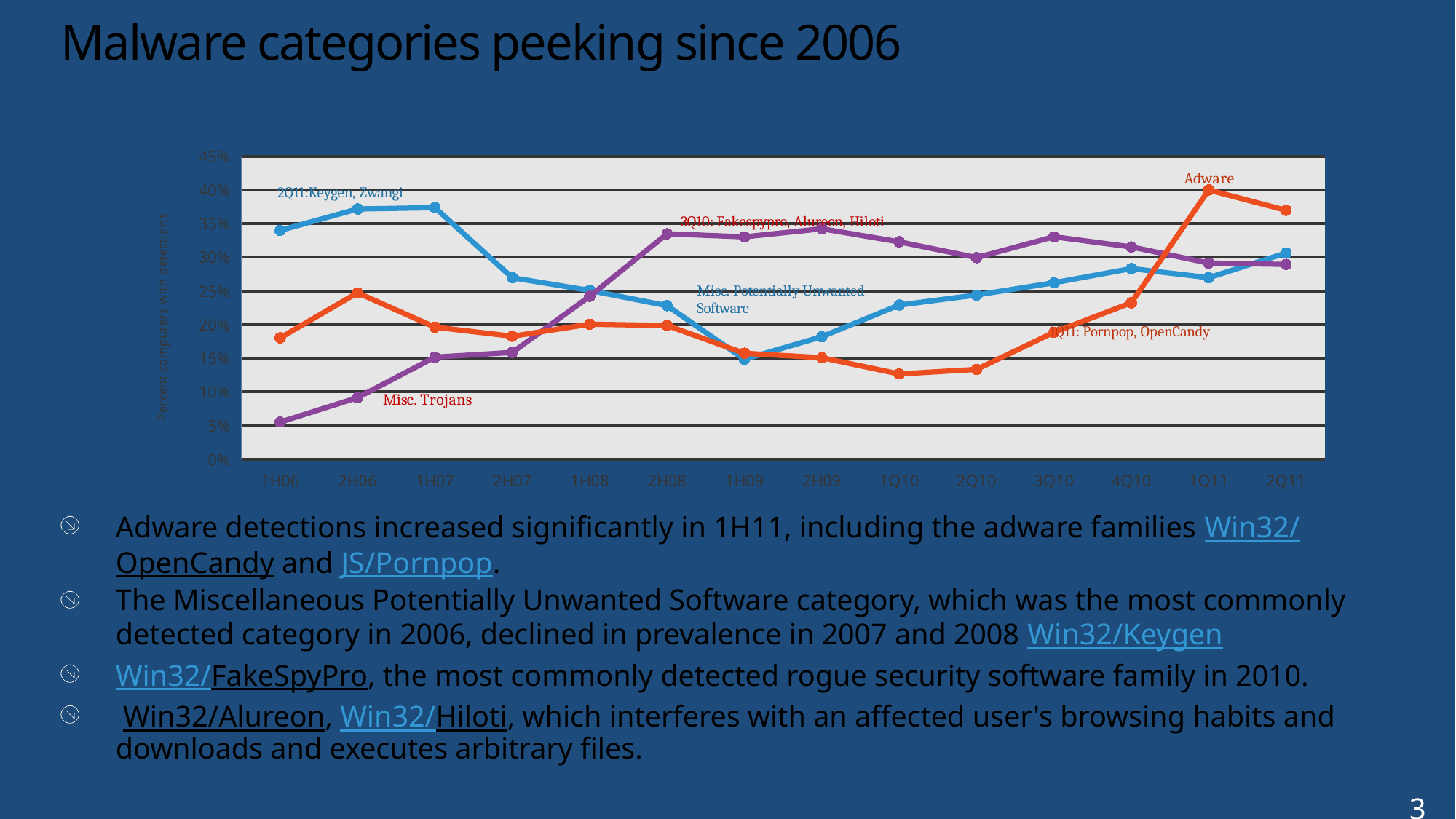
What is the label on the y axis of the chart? Percent computers with detections In 2H08, which series has the larger value: Misc. Trojans or Adware? Misc. Trojans How many data series are plotted on the chart? 3 Does the Misc. Trojans series rise or fall from 1H06 to 2H08? rise In which period does the Adware series reach its highest value? 1Q11 Is the value for Misc. Potentially Unwanted Software in 1H09 greater or less than 20%? less How many time periods are shown along the x axis of the chart? 14 What kind of chart is shown on the slide? line chart Is the value for Adware in 1Q11 greater or less than 35%? greater Is the value for Misc. Trojans in 1H06 greater or less than 10%? less In 1H06, which series has the larger value: Misc. Potentially Unwanted Software or Misc. Trojans? Misc. Potentially Unwanted Software In which period does the Misc. Trojans series have its lowest value? 1H06